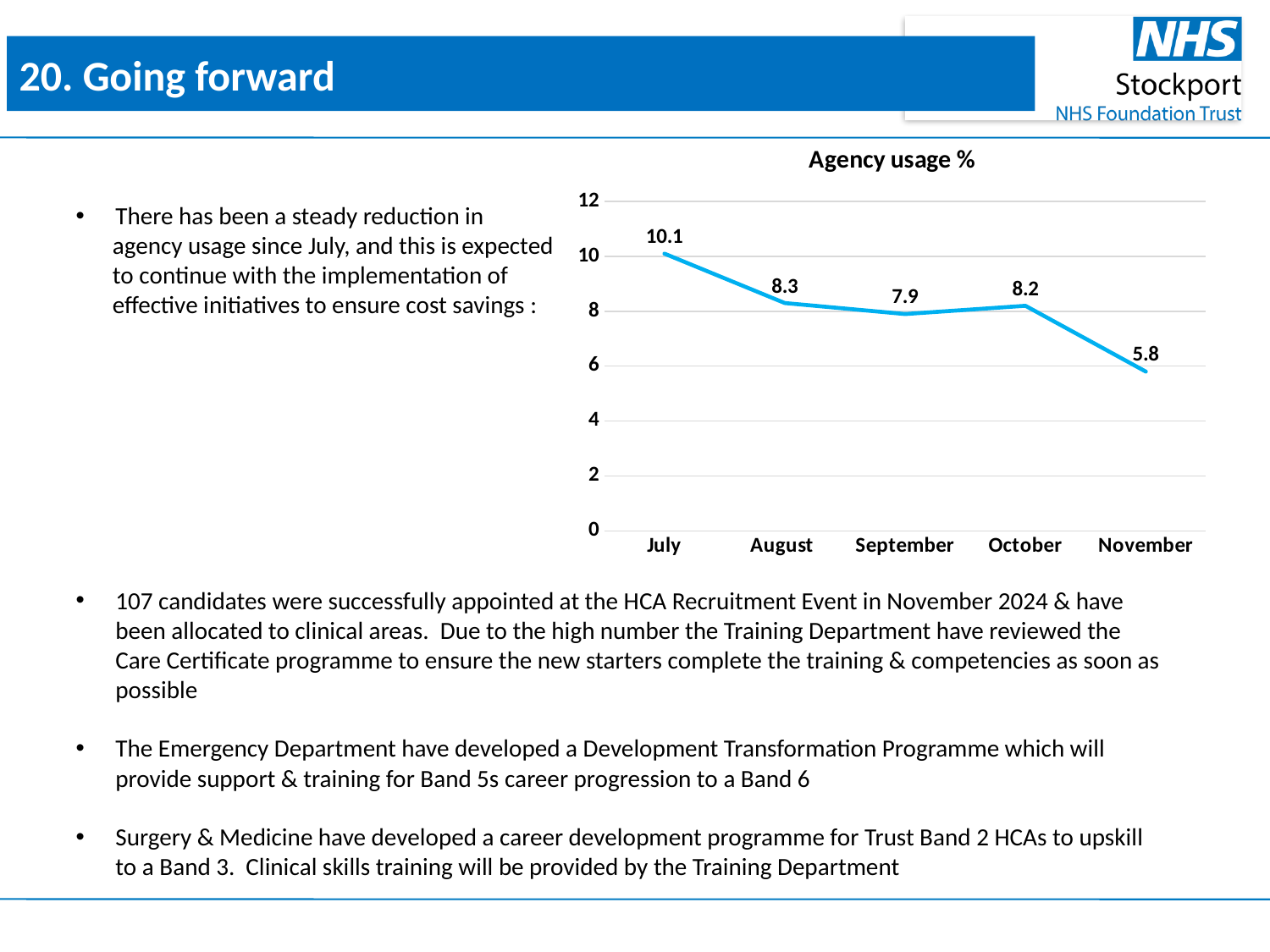
What is the agency usage % for November? 5.8 What is the agency usage % for July? 10.1 What is the title of the chart? Agency usage % What is the difference in agency usage % between August and September? 0.4 Is the agency usage % for October greater or less than 6? greater Which month has the highest agency usage %? July What is the agency usage % for September? 7.9 How many months are plotted on the chart? 5 What is the difference in agency usage % between July and November? 4.3 Which month has a higher agency usage %, August or October? August What kind of chart is shown on the slide? Line chart Which month has the lowest agency usage %? November